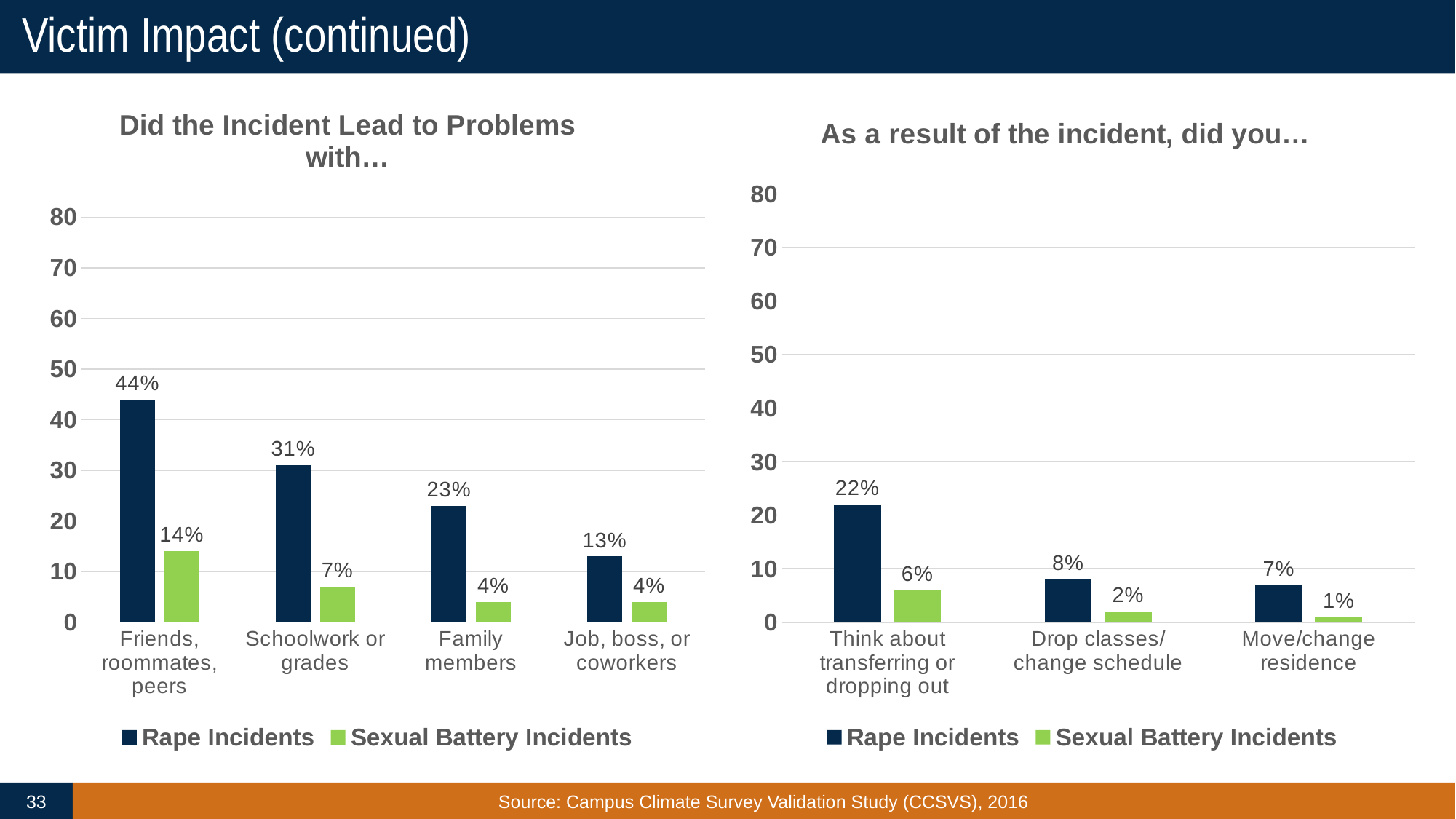
What kind of chart is the chart on the right of the slide? Bar chart In the chart 'As a result of the incident, did you…', what is the value for Rape Incidents for Think about transferring or dropping out? 22% In the chart 'As a result of the incident, did you…', what is the value for Sexual Battery Incidents for Move/change residence? 1% In the chart 'Did the Incident Lead to Problems with…', what is the value for Sexual Battery Incidents for Schoolwork or grades? 7% In the chart 'Did the Incident Lead to Problems with…', what is the difference between Rape Incidents and Sexual Battery Incidents for Family members? 19% In the chart 'Did the Incident Lead to Problems with…', which category has the highest value for Rape Incidents? Friends, roommates, peers In the chart 'Did the Incident Lead to Problems with…', is the Rape Incidents value for Schoolwork or grades greater or less than 30? greater In the chart 'As a result of the incident, did you…', how many series does the legend list? 2 In the chart 'As a result of the incident, did you…', which category has the lowest value for Sexual Battery Incidents? Move/change residence In the chart 'Did the Incident Lead to Problems with…', how many categories are shown on the x axis? 4 In the chart 'Did the Incident Lead to Problems with…', what is the value for Rape Incidents for Friends, roommates, peers? 44% In the chart 'As a result of the incident, did you…', which is larger: Rape Incidents for Drop classes/change schedule or Rape Incidents for Move/change residence? Drop classes/change schedule